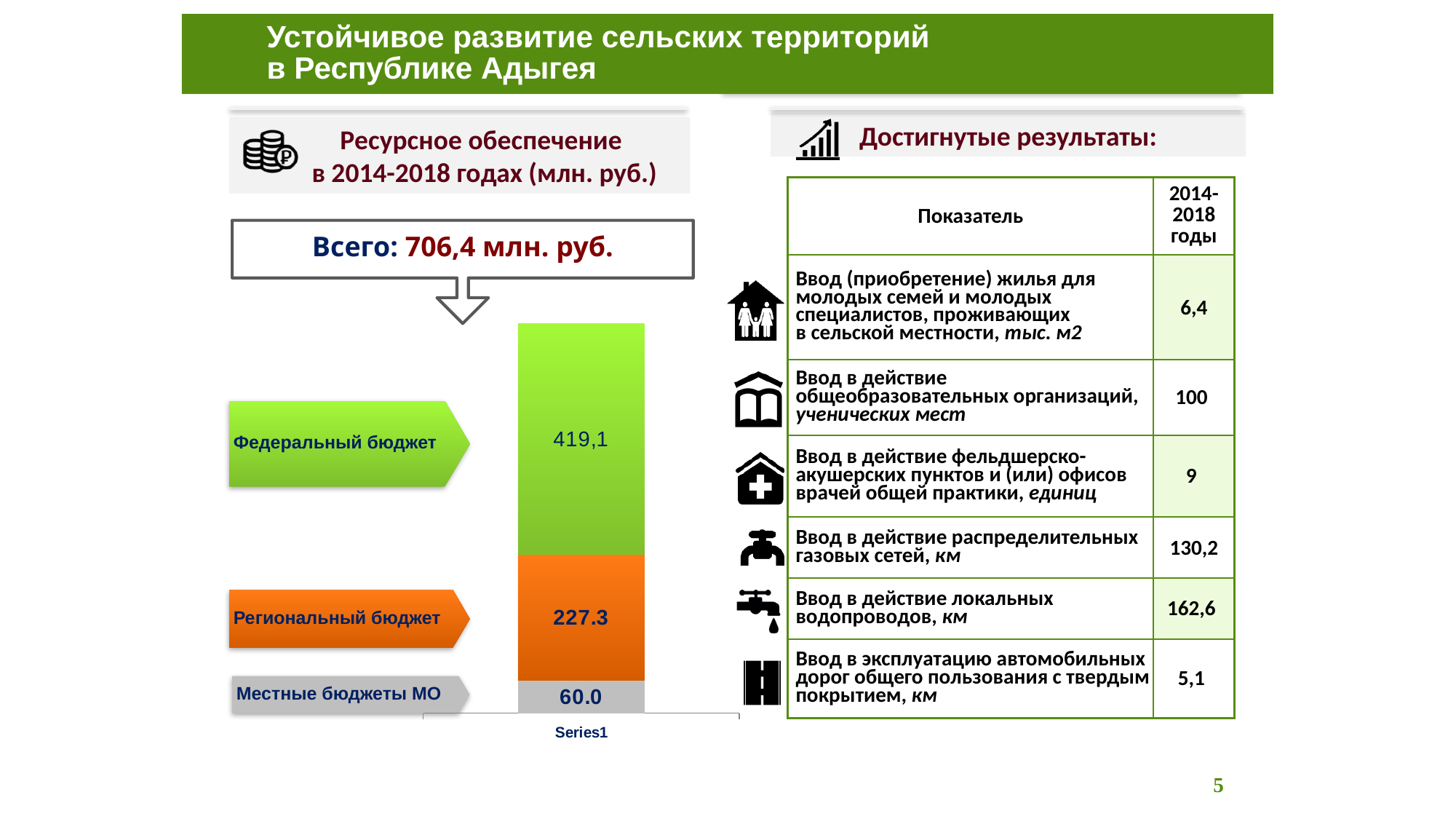
Which is larger in the stacked bar chart: Региональный бюджет or Местные бюджеты МО? Региональный бюджет What kind of chart is shown on the left of the slide? Stacked bar chart Which budget source has the smallest segment in the stacked bar? Местные бюджеты МО What is the difference between the Федеральный бюджет and Региональный бюджет values in the stacked bar chart? 191,8 What is the value for Федеральный бюджет in the stacked bar chart? 419,1 What is the total of the stacked bar (Всего) in млн. руб.? 706,4 млн. руб. What colour is the Региональный бюджет segment of the stacked bar? Orange Which budget source has the largest segment in the stacked bar? Федеральный бюджет What is the value for Местные бюджеты МО in the stacked bar chart? 60.0 What is the value for Региональный бюджет in the stacked bar chart? 227.3 What label appears under the bar on the x axis? Series1 How many segments make up the stacked bar? 3